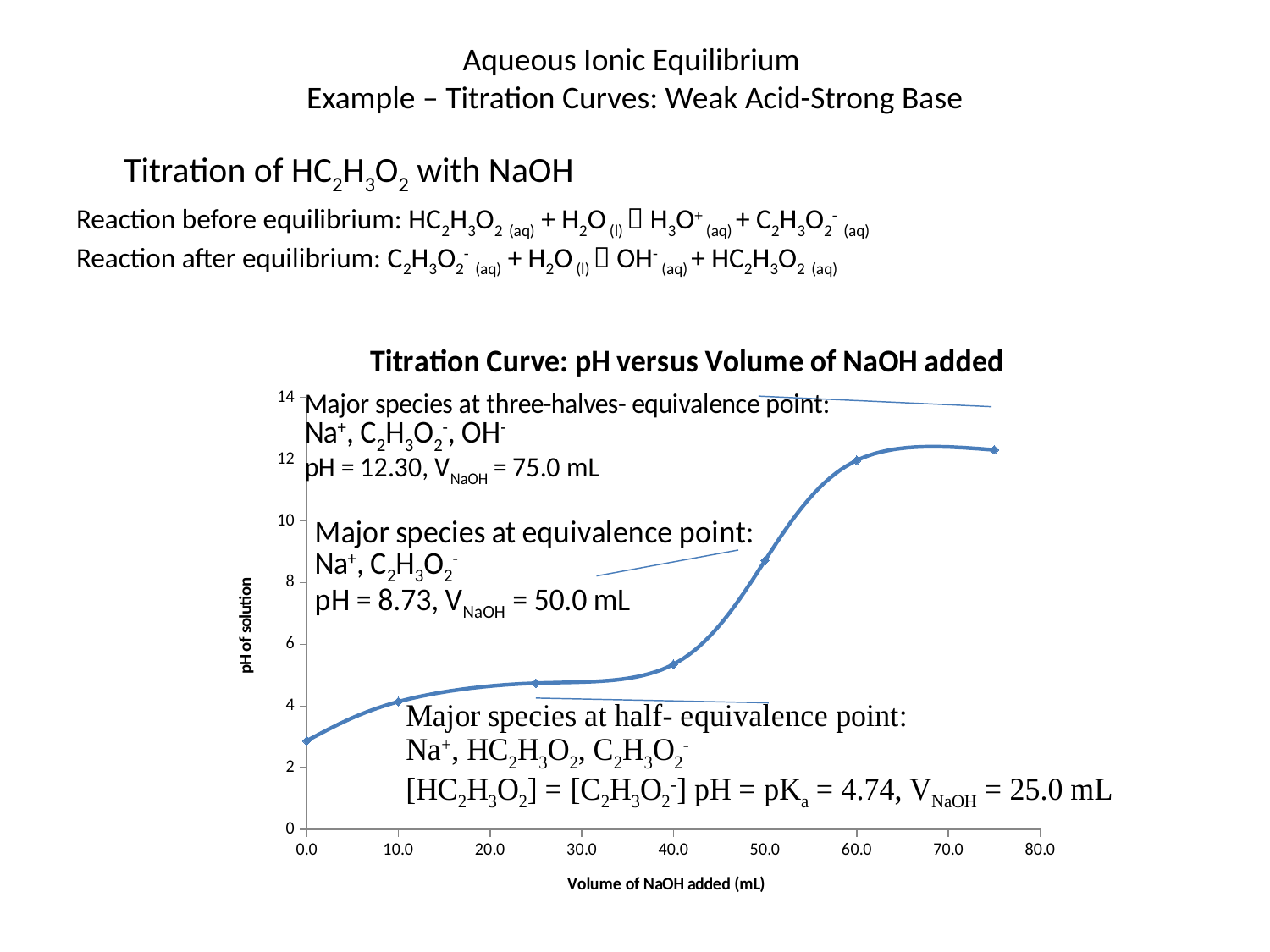
What is the difference between the pH at the equivalence point (50.0 mL) and the pH at the half-equivalence point (25.0 mL)? 3.99 What is the pH at the equivalence point, where 50.0 mL of NaOH has been added? 8.73 What kind of chart is shown on the slide? line chart Is the pH at 60.0 mL of NaOH added greater or less than 10? greater How many data points are plotted on the titration curve? 7 What is the pH at the half-equivalence point, where 25.0 mL of NaOH has been added? 4.74 What is the pH at the three-halves-equivalence point, where 75.0 mL of NaOH has been added? 12.30 Does the pH rise or fall as the volume of NaOH added increases? rises Is the pH at 40.0 mL of NaOH added greater or less than 6? less Is the pH at 0.0 mL of NaOH added greater or less than 4? less What is the title of the chart? Titration Curve: pH versus Volume of NaOH added What is the label of the x axis of the chart? Volume of NaOH added (mL)